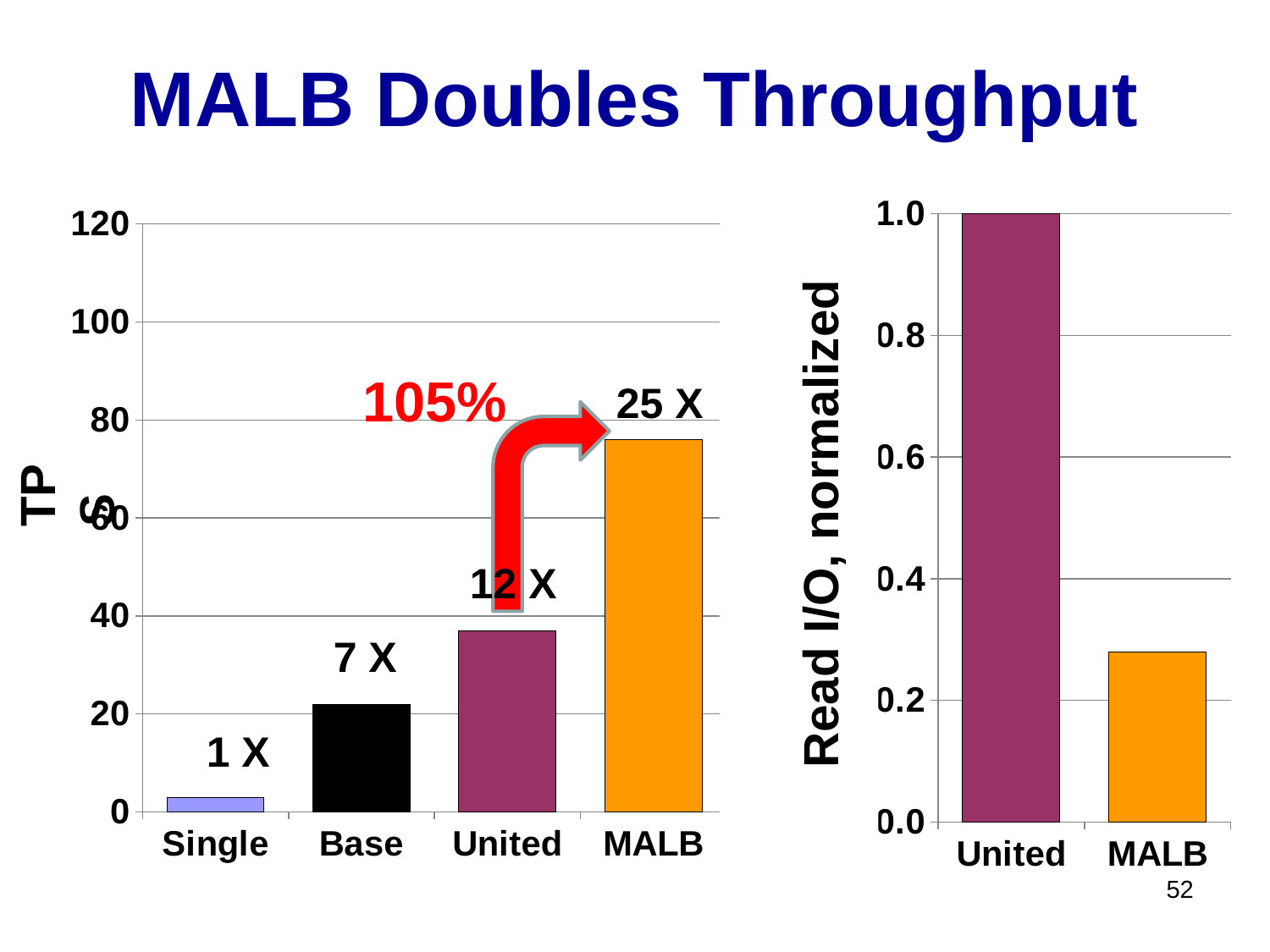
On the left chart (TP), what label is printed above the MALB bar? 25 X On the left chart (TP), how many categories are shown on the x axis? 4 On the left chart (TP), is the value for United greater or less than 40? less On the right chart (Read I/O, normalized), is the value for MALB greater or less than 0.4? less On the left chart (TP), do the bar values rise or fall from Single to MALB? rise On the left chart (TP), what label is printed above the Base bar? 7 X What kind of chart is the right chart (Read I/O, normalized)? bar chart On the left chart (TP), is the value for MALB greater or less than 80? less On the left chart (TP), which category has the highest bar? MALB On the left chart (TP), which category has the lowest bar? Single On the right chart (Read I/O, normalized), what is the value for United? 1.0